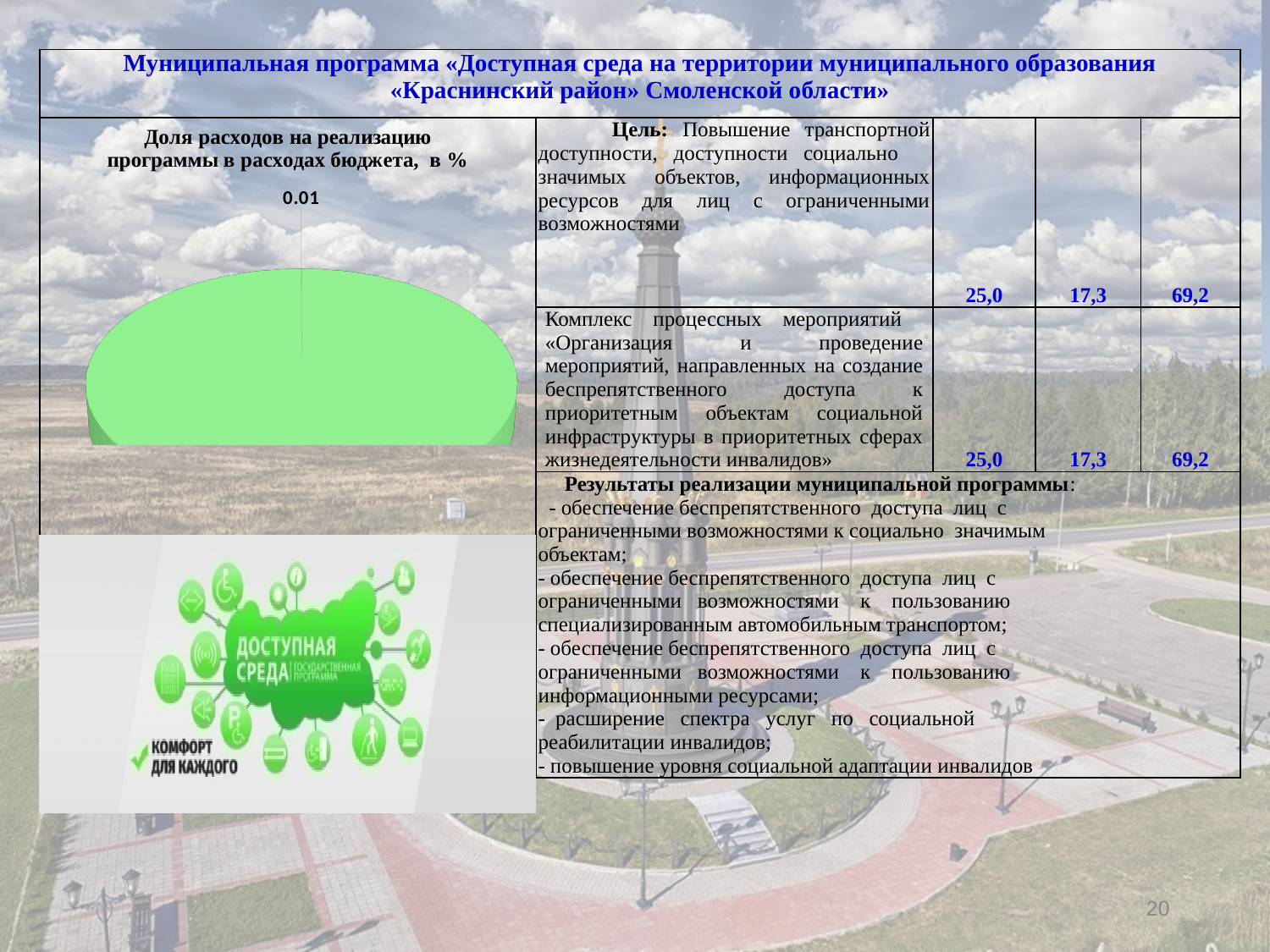
How many slices are visible in the pie chart? 1 What colour is the slice of the pie chart? green What is the title of the pie chart? Доля расходов на реализацию программы в расходах бюджета, в % What kind of chart is shown on the left of the slide? pie chart Is the value labelled on the pie chart greater or less than 1? less What value is printed as the data label on the pie chart? 0.01